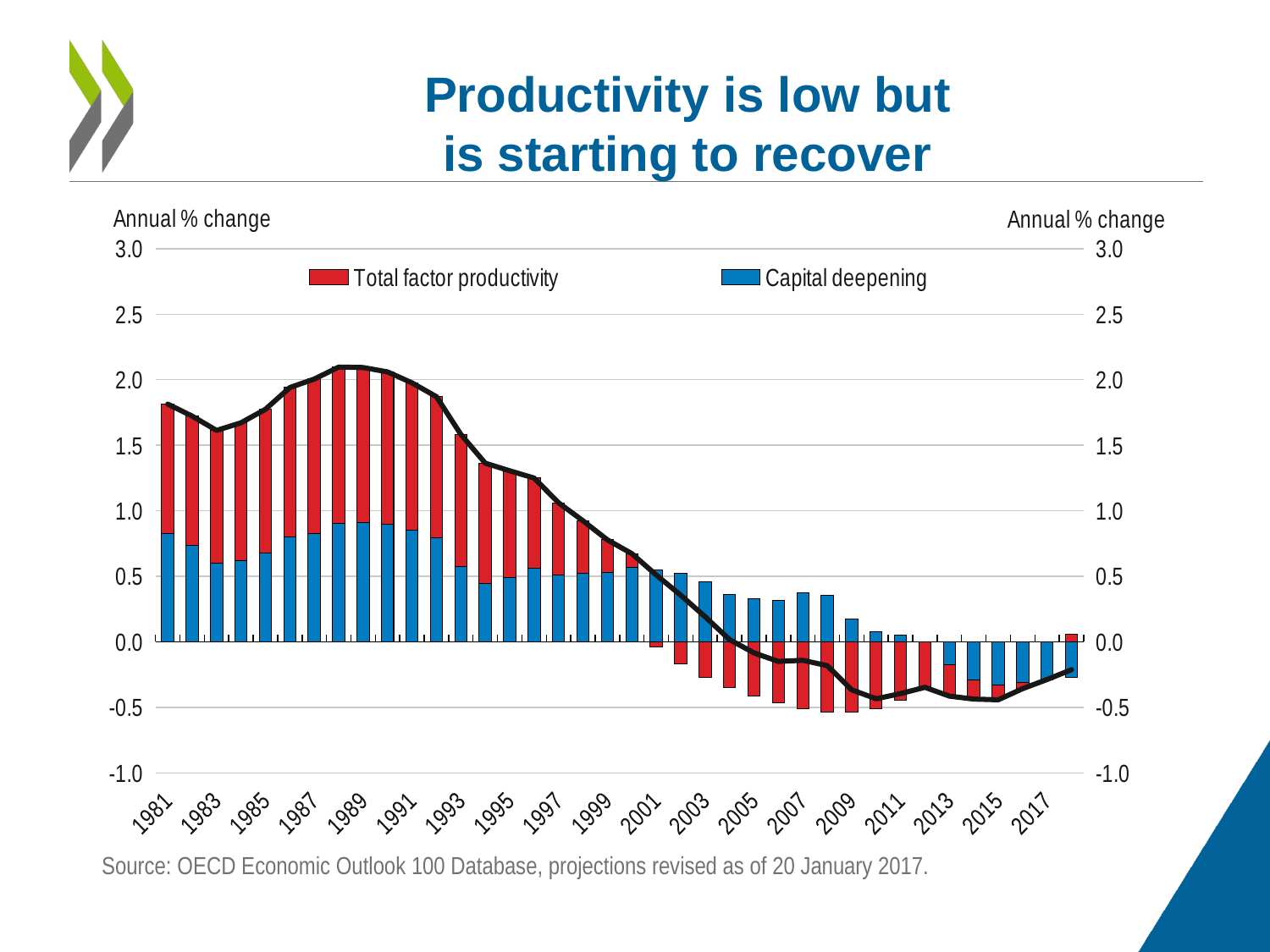
Is the Capital deepening value for 2013 greater or less than 0.0? less Which year has the larger Capital deepening value, 1981 or 2009? 1981 Is the value of the black line for 2017 greater or less than 0.0? less Is the Capital deepening value for 1981 greater or less than 0.5? greater How many series does the legend list? 2 Does the black line rise or fall between 1989 and 2009? fall Which series is shown in red in the legend? Total factor productivity What is the label on the vertical axis of the chart? Annual % change What kind of chart is shown on the slide? combination bar and line chart